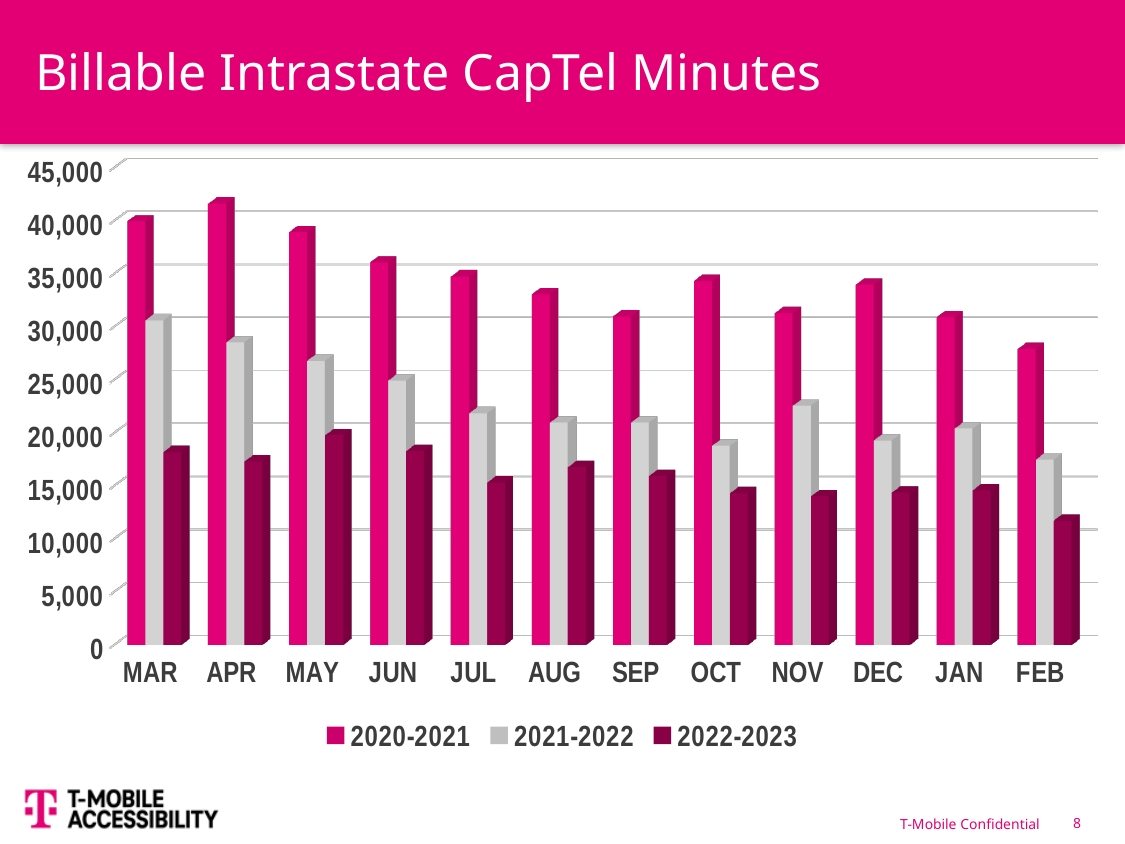
Is the value for JUL in the 2021-2022 series greater or less than 25,000? less Which month has the lowest value for the 2020-2021 series? FEB In the 2021-2022 series, which is larger, OCT or NOV? NOV How many series does the legend list? 3 Is the value for MAR in the 2020-2021 series greater or less than 35,000? greater What is the title of the chart? Billable Intrastate CapTel Minutes Which month has the highest value for the 2020-2021 series? APR What kind of chart is shown on the slide? Bar chart How many months are shown on the x axis? 12 Which month has the lowest value for the 2021-2022 series? FEB Which month has the highest value for the 2022-2023 series? MAY Is the value for FEB in the 2022-2023 series greater or less than 15,000? less